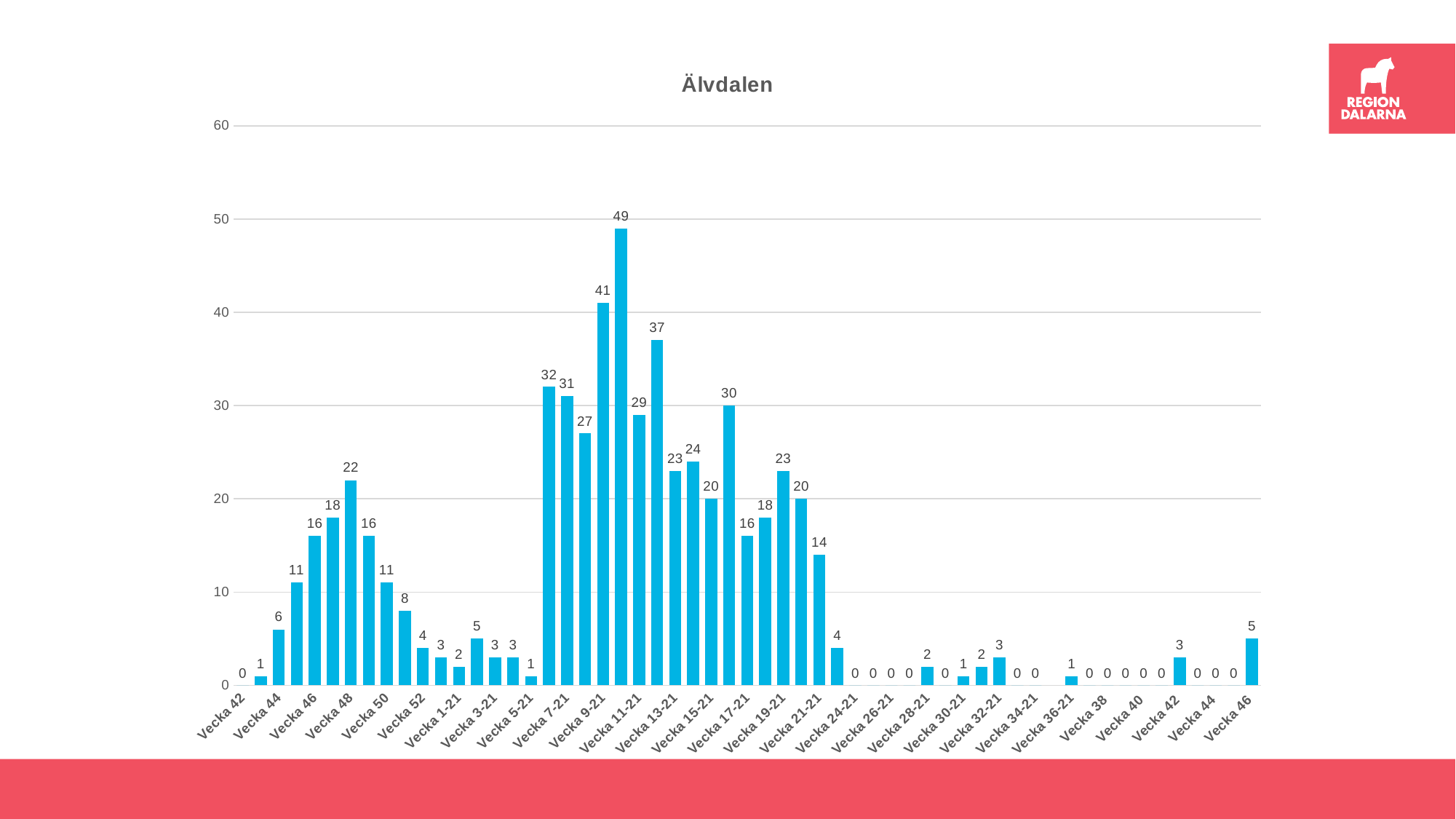
What is the value for Vecka 48? 22 What is the value for Vecka 9-21? 41 What is the title of the chart? Älvdalen Do the values rise or fall from Vecka 42 to Vecka 48 at the left of the chart? rise What is the value for Vecka 19-21? 23 What type of chart is shown on the slide? bar chart What is the value for Vecka 11-21? 29 What is the value for the last bar on the right, labelled Vecka 46? 5 What is the difference between the values for Vecka 11-21 and Vecka 9-21? 12 Which is larger, the value for Vecka 7-21 or the value for Vecka 13-21? Vecka 7-21 What is the value for Vecka 50? 11